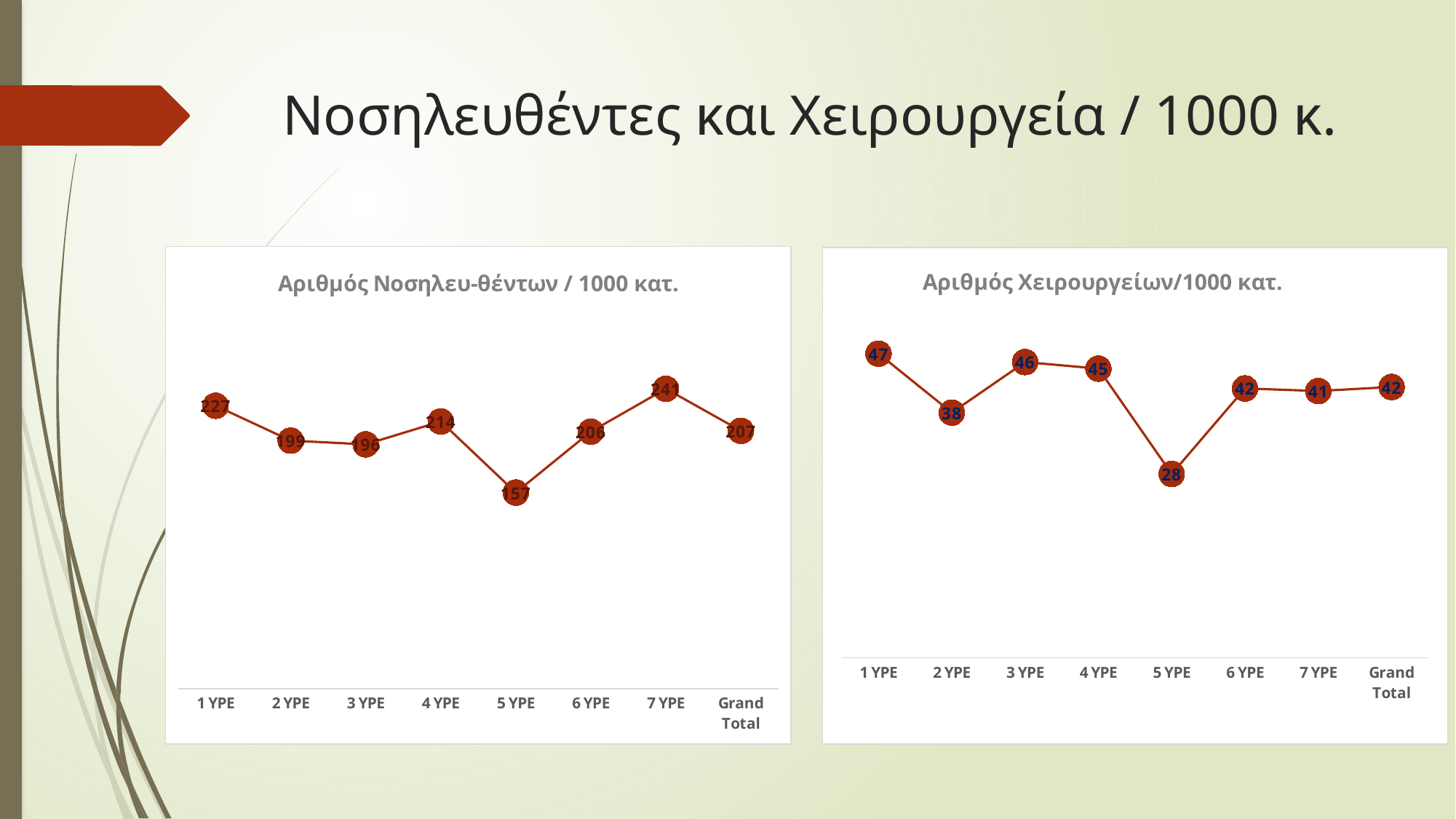
In the right chart (Αριθμός Χειρουργείων/1000 κατ.), how many categories are shown on the x axis? 8 In the left chart (Αριθμός Νοσηλευ-θέντων / 1000 κατ.), what is the value for 5 ΥΠΕ? 157 In the left chart (Αριθμός Νοσηλευ-θέντων / 1000 κατ.), what is the difference between the values for 1 ΥΠΕ and 2 ΥΠΕ? 28 In the right chart (Αριθμός Χειρουργείων/1000 κατ.), which category has the highest value? 1 YPE In the right chart (Αριθμός Χειρουργείων/1000 κατ.), which category has the lowest value? 5 YPE In the left chart (Αριθμός Νοσηλευ-θέντων / 1000 κατ.), which category has the lowest value? 5 YPE In the right chart (Αριθμός Χειρουργείων/1000 κατ.), what is the value for 2 ΥΠΕ? 38 In the right chart (Αριθμός Χειρουργείων/1000 κατ.), what is the Grand Total value? 42 What kind of chart is the left chart (Αριθμός Νοσηλευ-θέντων / 1000 κατ.)? Line chart In the right chart (Αριθμός Χειρουργείων/1000 κατ.), what is the difference between the values for 1 ΥΠΕ and 5 ΥΠΕ? 19 In the left chart (Αριθμός Νοσηλευ-θέντων / 1000 κατ.), what is the value for 7 ΥΠΕ? 241 In the left chart (Αριθμός Νοσηλευ-θέντων / 1000 κατ.), which category has the highest value? 7 YPE